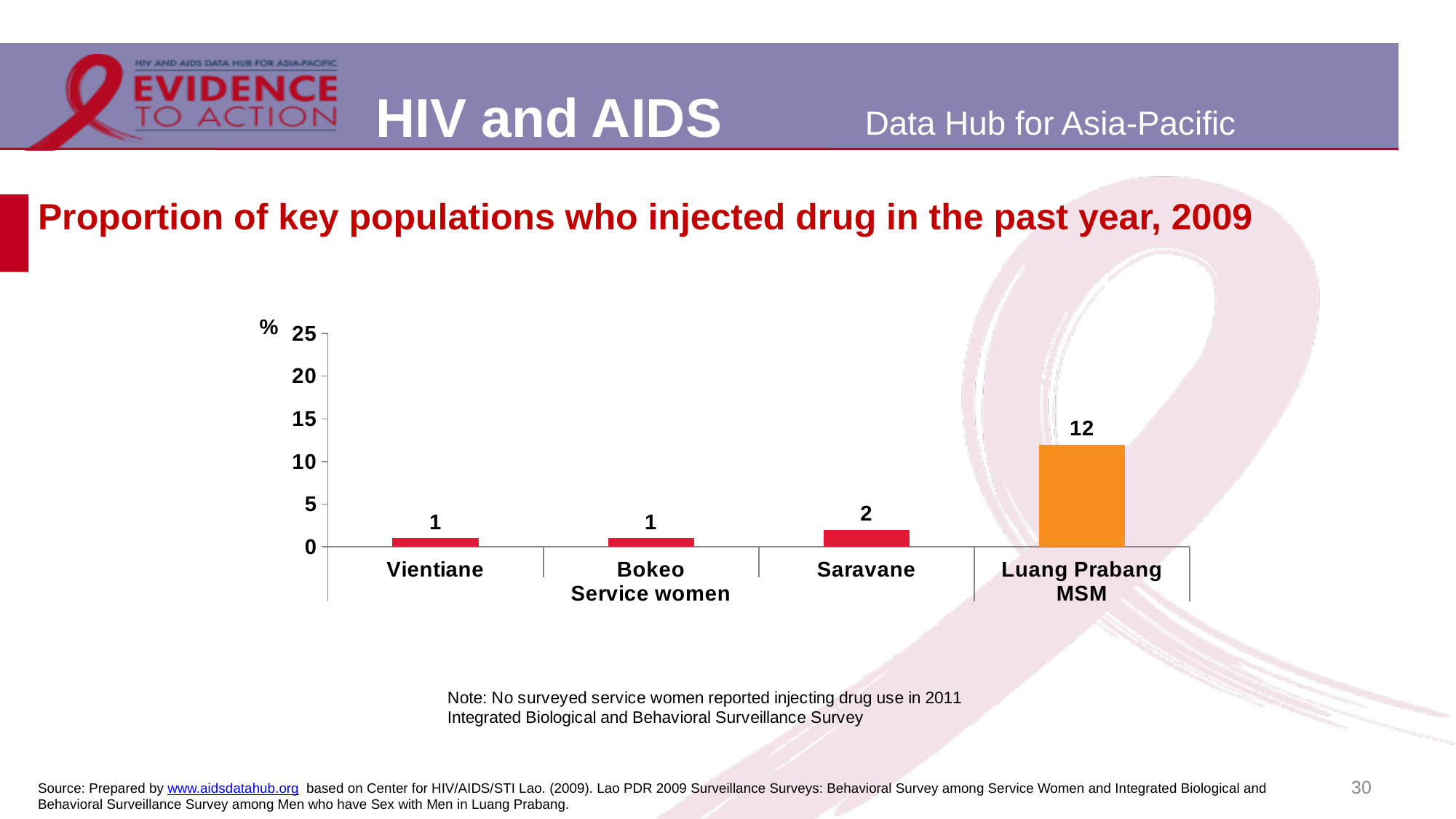
What is the difference between the values for Luang Prabang and Saravane? 10 What is the difference between the values for Saravane and Vientiane? 1 Which is larger, the value for Saravane or the value for Bokeo? Saravane What is the value for Luang Prabang (MSM)? 12 What is the title of the chart? Proportion of key populations who injected drug in the past year, 2009 What kind of chart is shown on the slide? bar chart Which category has the highest value? Luang Prabang What unit is shown on the y axis? % What is the value for Vientiane? 1 How many categories are shown on the x axis? 4 What is the value for Saravane? 2 Is the value for Luang Prabang greater or less than 10? greater